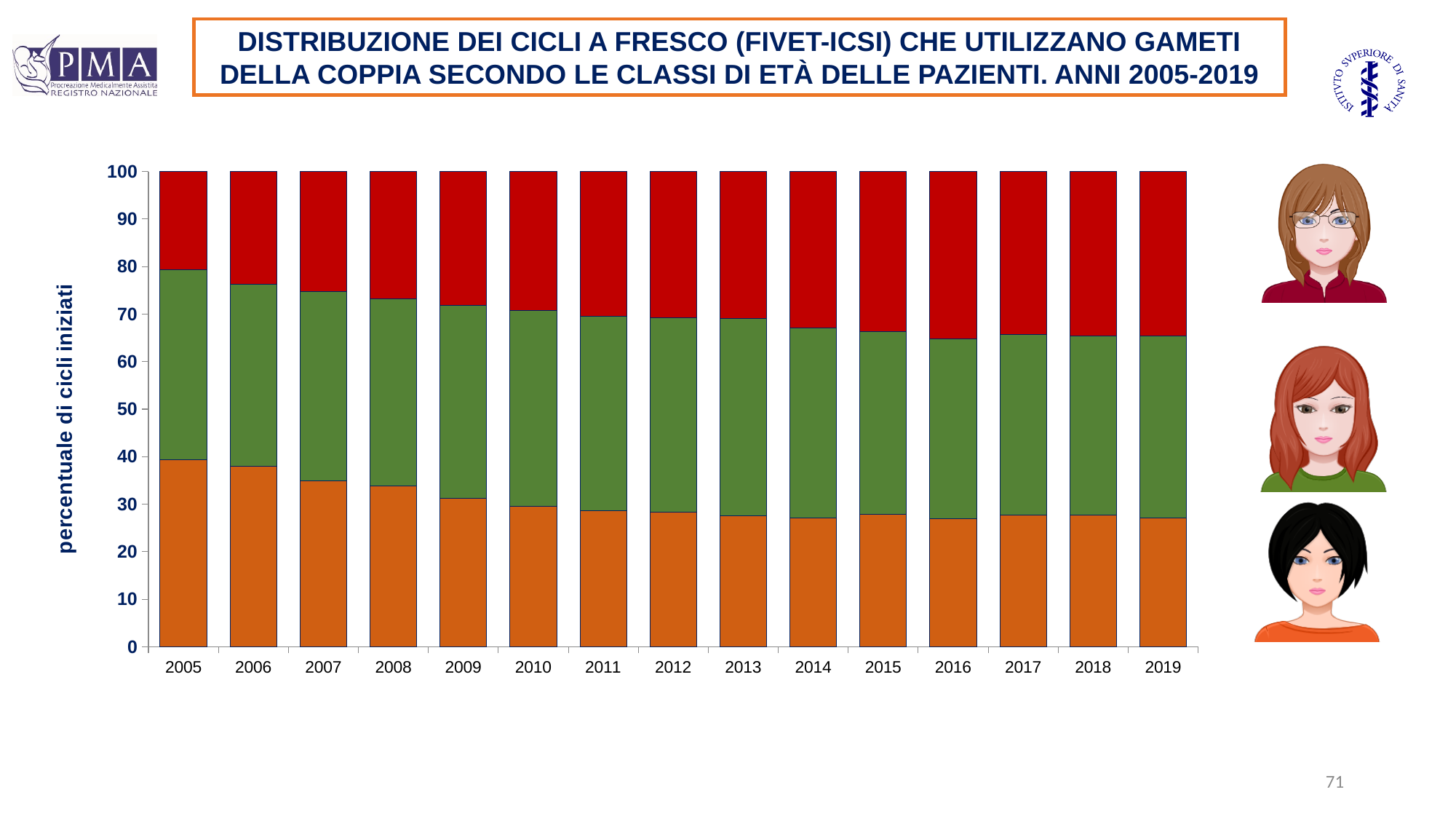
What kind of chart is shown on the slide? stacked bar chart What is the total height of the stacked bar for 2010? 100 Does the orange segment rise or fall from 2005 to 2019? fall How many years are shown along the x axis of the chart? 15 Is the orange segment for 2019 greater or less than 30? less How many coloured segments make up each stacked bar? 3 What is the label of the y axis? percentuale di cicli iniziati Is the orange segment for 2005 greater or less than 30? greater Is the top of the green segment for 2005 greater or less than 70? greater Which year has the larger orange segment, 2005 or 2019? 2005 Which year has the largest orange segment? 2005